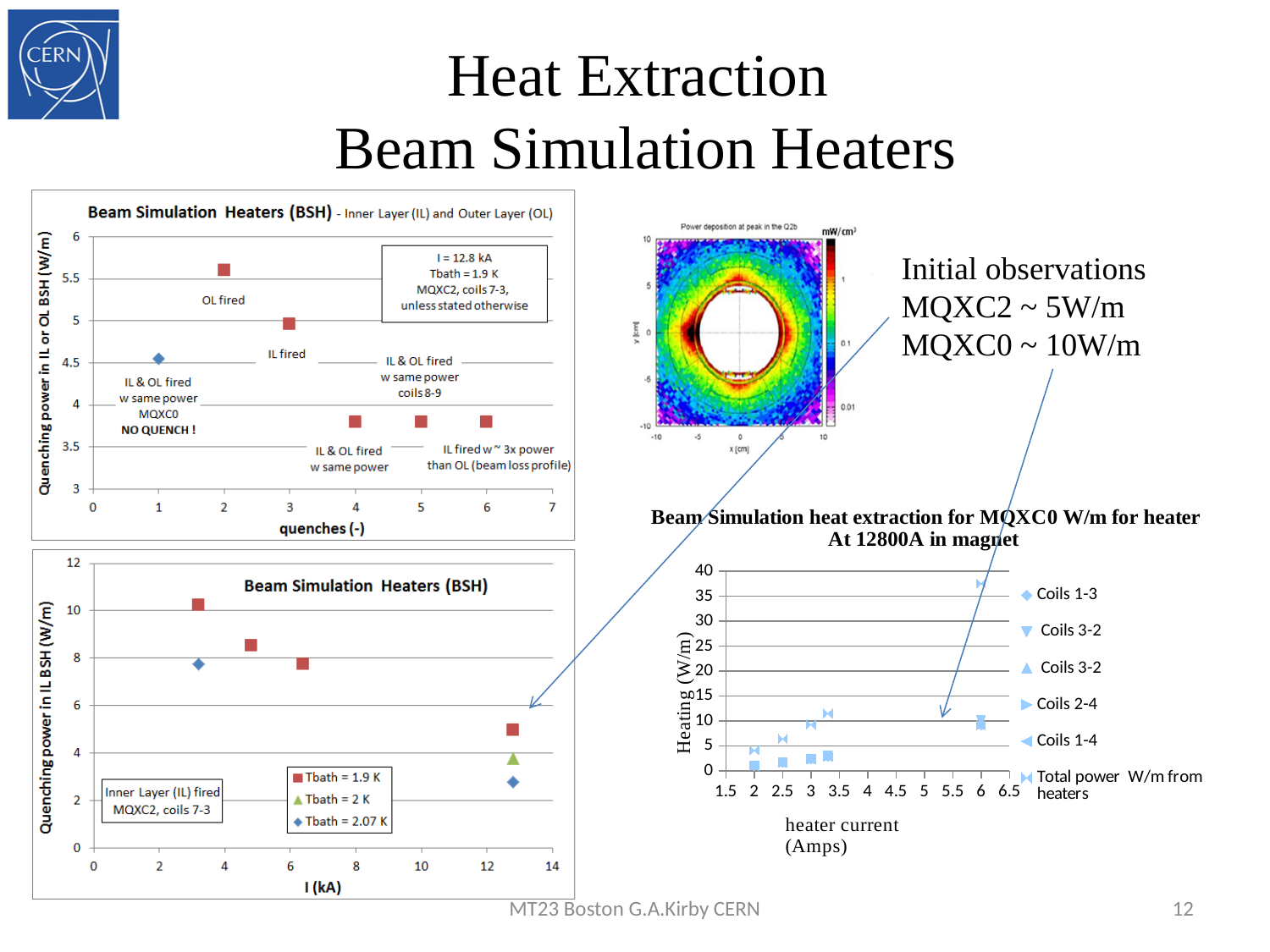
In the bottom-left chart (quenching power vs I (kA)), at about 12.8 kA, which series has the larger quenching power: Tbath = 1.9 K or Tbath = 2.07 K? Tbath = 1.9 K How many series does the legend of the bottom-left chart 'Beam Simulation Heaters (BSH)' (quenching power vs I (kA)) list? 3 In the top-left chart (quenching power vs quenches), which quench number has the highest quenching power? 2 In the bottom-right chart (heat extraction for MQXC0), is the Total power value at a heater current of 6 Amps greater or less than 35 W/m? greater In the bottom-left chart (quenching power vs I (kA)), do the Tbath = 1.9 K values rise or fall as the current increases? fall In the bottom-left chart (quenching power vs I (kA)), is the highest Tbath = 1.9 K value greater or less than 10 W/m? greater How many entries does the legend of the bottom-right chart 'Beam Simulation heat extraction for MQXC0 W/m for heater At 12800A in magnet' list? 6 In the top-left chart (quenching power vs quenches), is the value at quench 4 greater or less than 4 W/m? less In the bottom-right chart (heat extraction for MQXC0), what is the label of the y axis? Heating (W/m) In the top-left chart (quenching power vs quenches), what is the label of the x axis? quenches (-) What kind of chart is the top-left chart titled 'Beam Simulation Heaters (BSH) - Inner Layer (IL) and Outer Layer (OL)'? scatter chart